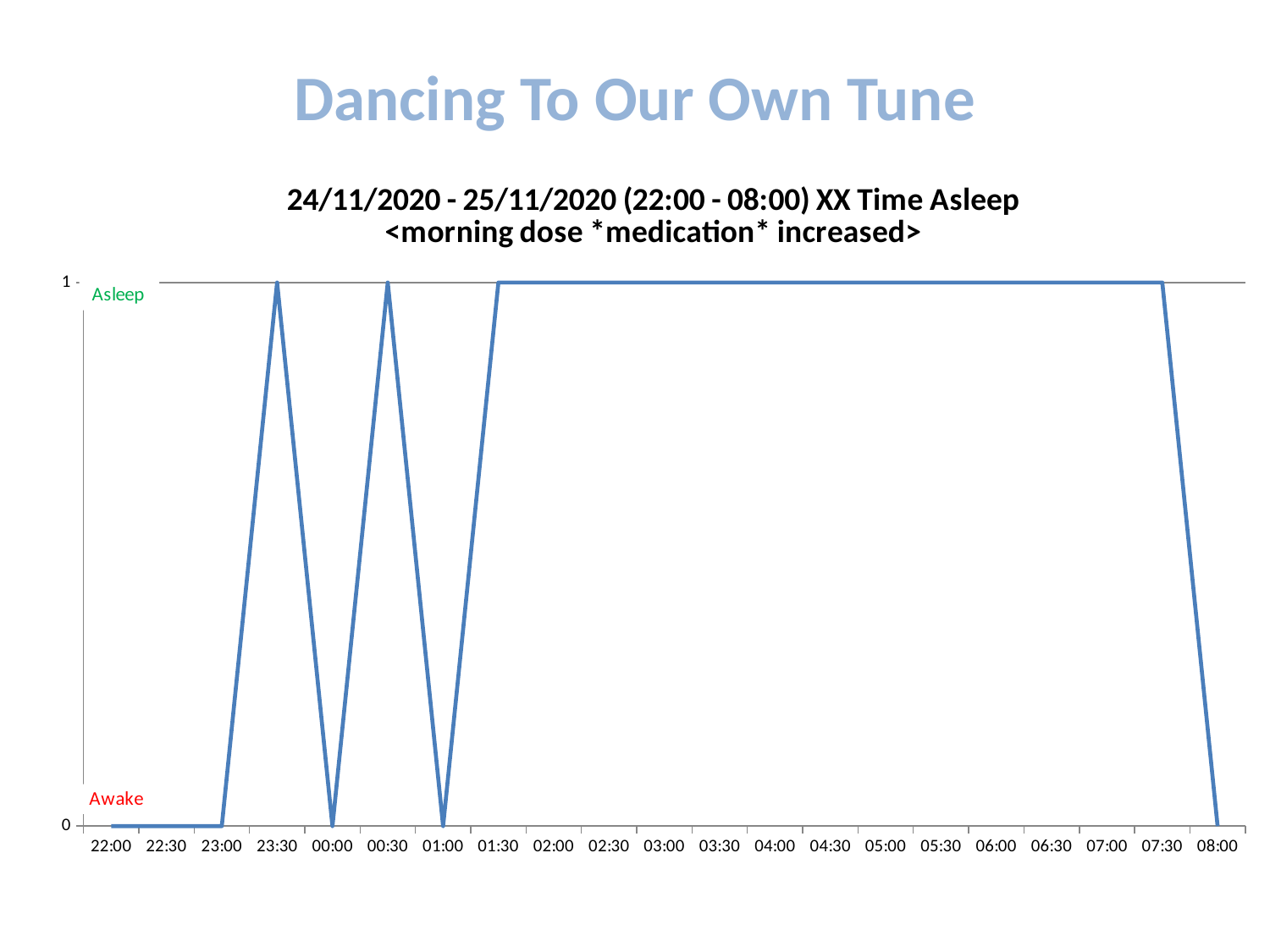
Between 01:30 and 07:30, does the line rise, fall, or stay flat? stay flat What is the value at 23:30? 1 What is the value at 01:00? 0 What label is shown in green next to the value 1 on the y axis? Asleep What is the value at 00:00? 0 What kind of chart is shown on the slide? line chart What is the difference between the value at 00:30 and the value at 01:00? 1 How many time points are labelled on the x axis? 21 What is the value at 04:00? 1 What is the value at 22:00? 0 What is the value at 08:00? 0 Which is larger, the value at 23:30 or the value at 00:00? 23:30